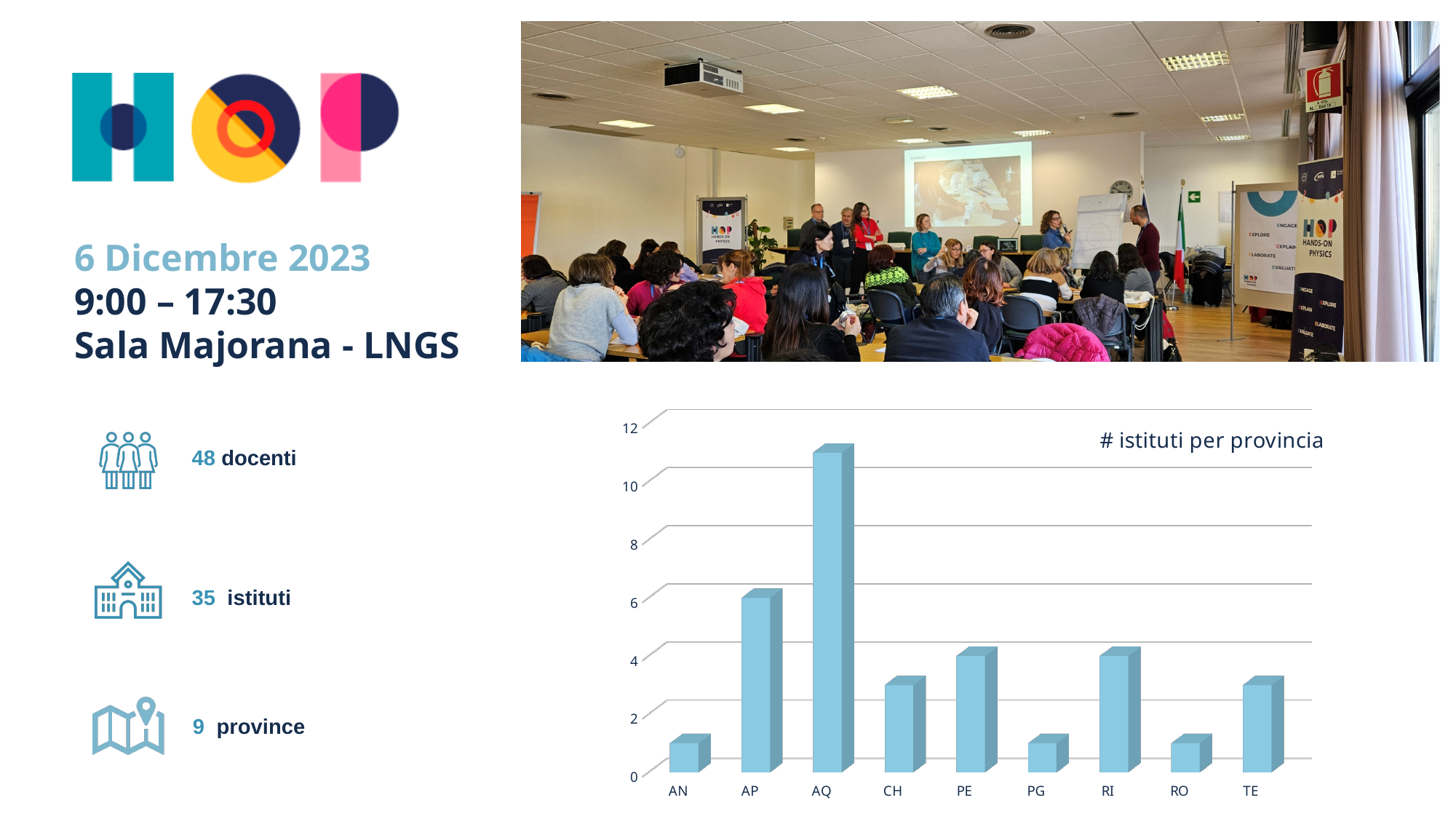
What type of chart is shown on the slide? bar chart Which province has the highest number of istituti in the chart? AQ What is the title of the chart? # istituti per provincia Is the value for CH greater or less than 4? less What is the value for AP in the chart? 6 How many provinces are shown on the x axis of the chart? 9 Is the value for AN greater or less than 2? less What is the value for PE in the chart? 4 What is the value for RI in the chart? 4 Which is larger in the chart, the value for AP or the value for CH? AP What is the difference between the values for AP and PE in the chart? 2 Is the value for AQ greater or less than 10? greater